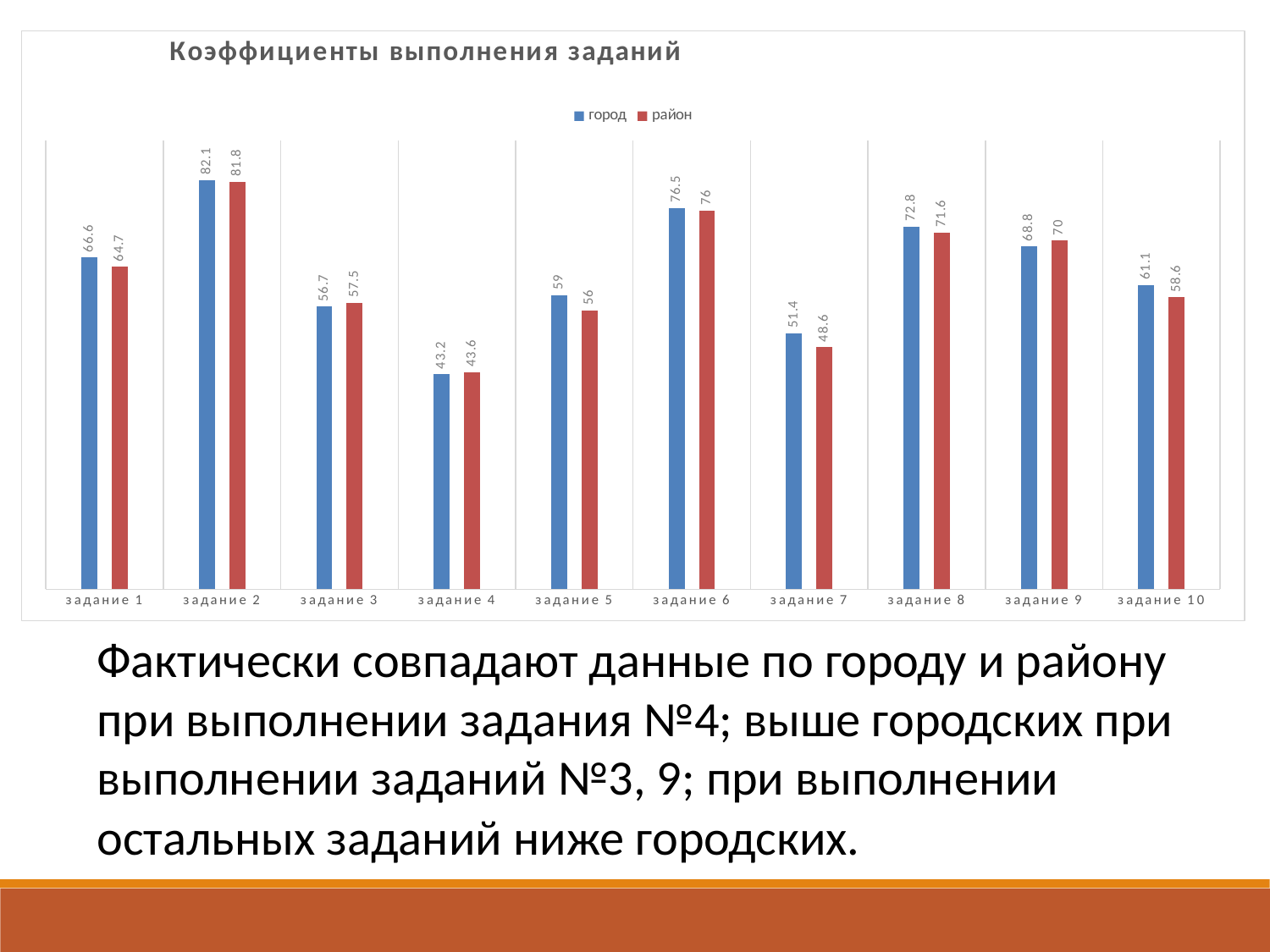
What is the title of the chart? Коэффициенты выполнения заданий What kind of chart is shown on the slide? bar chart How many tasks (categories) are shown on the x axis? 10 What is the difference between the город values for задание 2 and задание 4? 38.9 How many series does the legend list? 2 What is the value for город for задание 1? 66.6 What is the value for район for задание 9? 70 Which task has the lowest value for район? задание 4 What is the value for район for задание 7? 48.6 What is the difference between the город and район values for задание 7? 2.8 Which task has the highest value for город? задание 2 For задание 5, which is larger: город or район? город